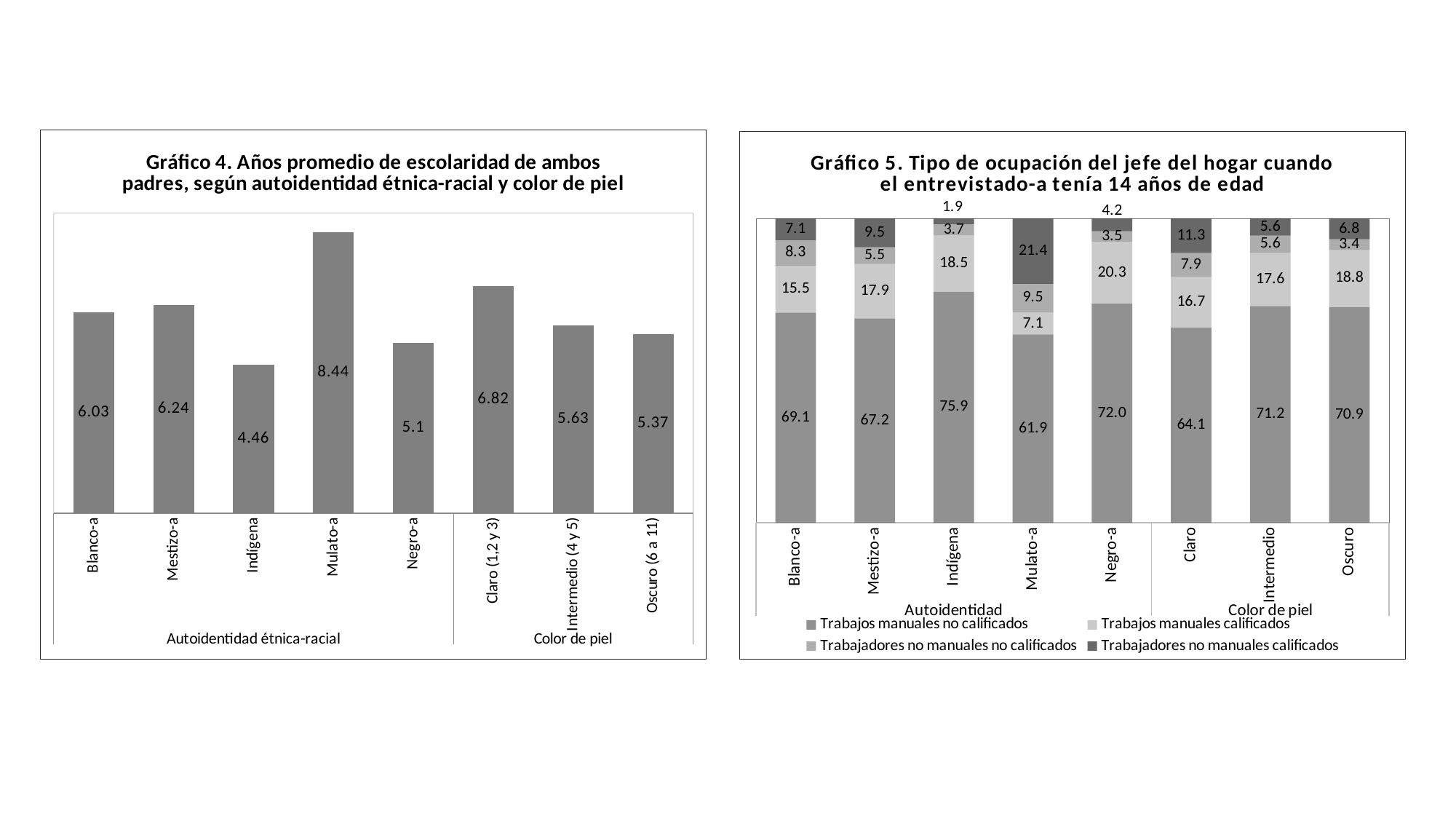
In Gráfico 4, which category has the lowest value? Indígena In Gráfico 5, what is the difference between the Trabajos manuales calificados values for Negro-a and Claro? 3.6 In Gráfico 5, what is the value of Trabajos manuales no calificados for Indígena? 75.9 In Gráfico 4, which category has the highest value? Mulato-a In Gráfico 5, how many series does the legend list? 4 In Gráfico 5, which category has the lowest value for Trabajos manuales no calificados? Mulato-a In Gráfico 5, what is the value of Trabajadores no manuales calificados for Mulato-a? 21.4 In Gráfico 4, what is the difference between the values for Claro (1,2 y 3) and Oscuro (6 a 11)? 1.45 In Gráfico 4, which is larger, the value for Blanco-a or the value for Mestizo-a? Mestizo-a In Gráfico 4, how many bars are plotted? 8 What kind of chart is Gráfico 4? Bar chart In Gráfico 4, what is the average years of schooling for Mulato-a? 8.44